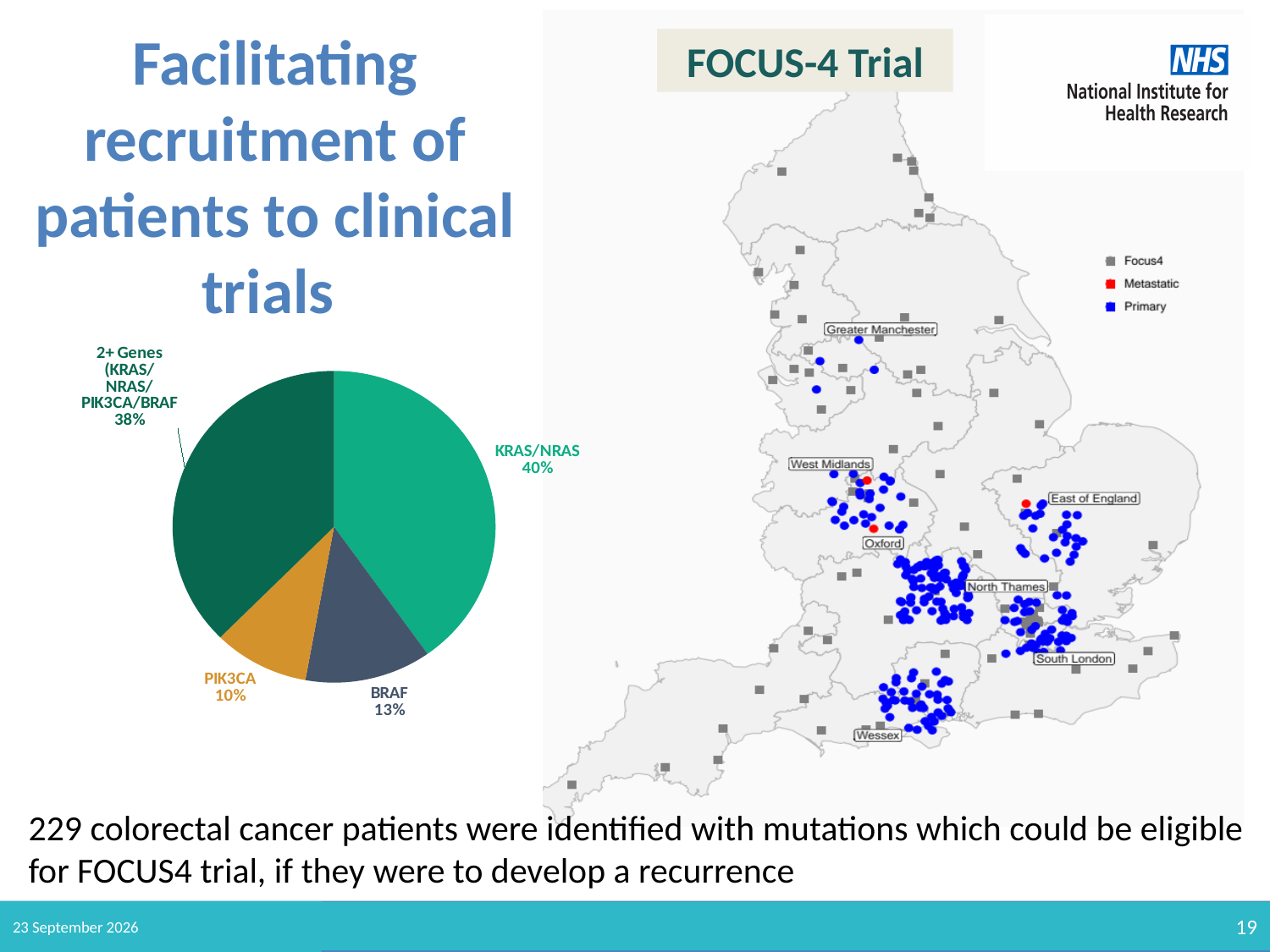
In the pie chart, what percentage is shown for PIK3CA? 10% In the pie chart, what percentage is shown for BRAF? 13% In the pie chart, which is larger, BRAF or PIK3CA? BRAF How many slices does the pie chart have? 4 In the pie chart, which category has the largest share? KRAS/NRAS In the pie chart, what percentage is shown for 2+ Genes (KRAS/NRAS/PIK3CA/BRAF)? 38% What type of chart is shown on the left side of the slide? Pie chart In the pie chart, which category has the smallest share? PIK3CA In the pie chart, what is the difference in percentage points between 2+ Genes and PIK3CA? 28 In the pie chart, what is the difference in percentage points between KRAS/NRAS and BRAF? 27 In the pie chart, what percentage is shown for KRAS/NRAS? 40% In the pie chart, what colour is the PIK3CA slice? Orange/gold